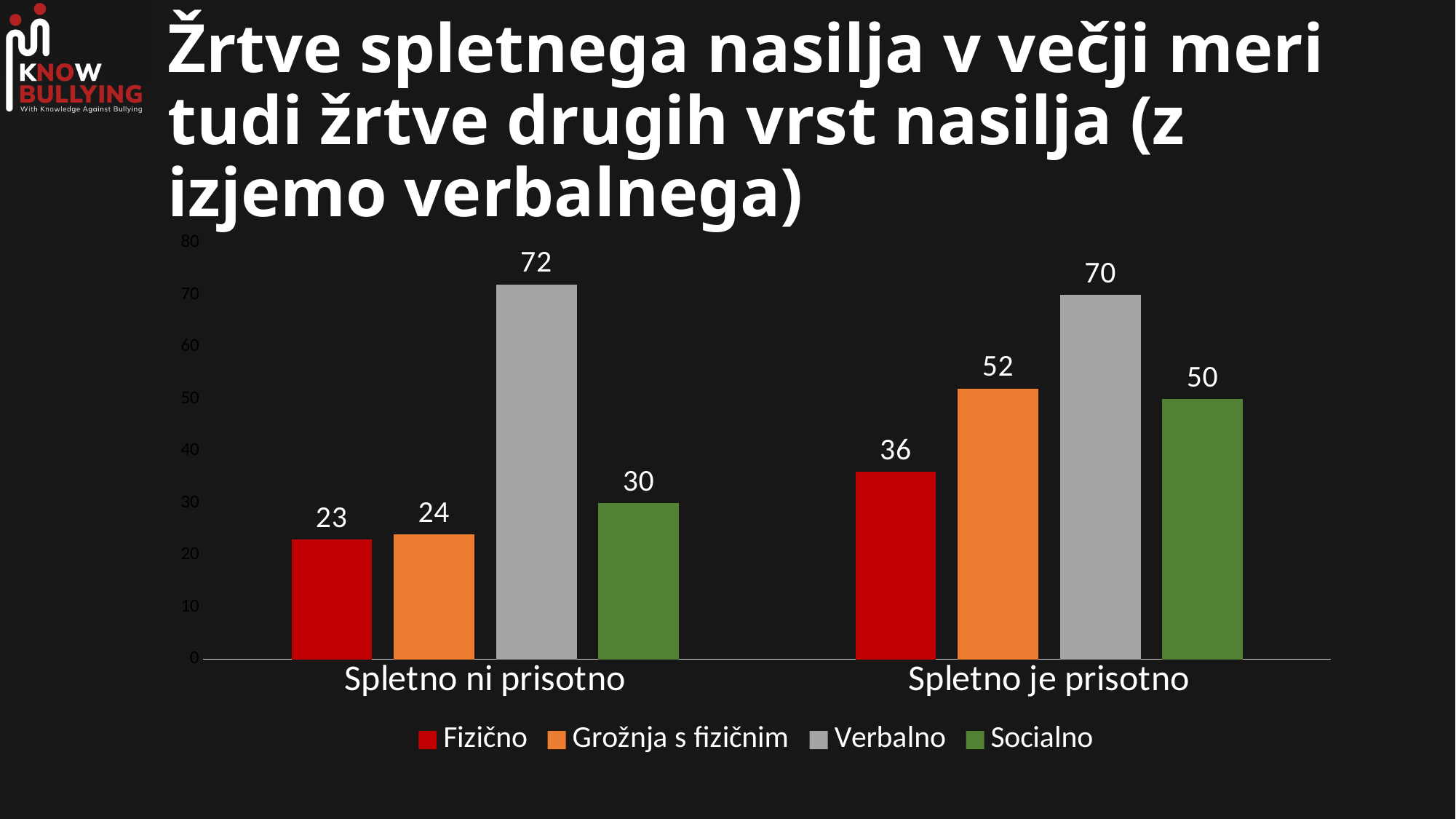
Which series has the lowest value in the Spletno ni prisotno category? Fizično How many categories are shown on the x axis? 2 What kind of chart is shown on the slide? bar chart What colour are the Grožnja s fizičnim bars? orange Which series has the highest value in the Spletno je prisotno category? Verbalno Which is larger: Verbalno for Spletno ni prisotno or Verbalno for Spletno je prisotno? Spletno ni prisotno Is the value for Socialno in the Spletno ni prisotno category greater or less than 40? less What is the value for Verbalno in the Spletno ni prisotno category? 72 How many series does the legend list? 4 What is the value for Fizično in the Spletno je prisotno category? 36 What is the difference between the Grožnja s fizičnim values for Spletno je prisotno and Spletno ni prisotno? 28 What is the value for Socialno in the Spletno je prisotno category? 50